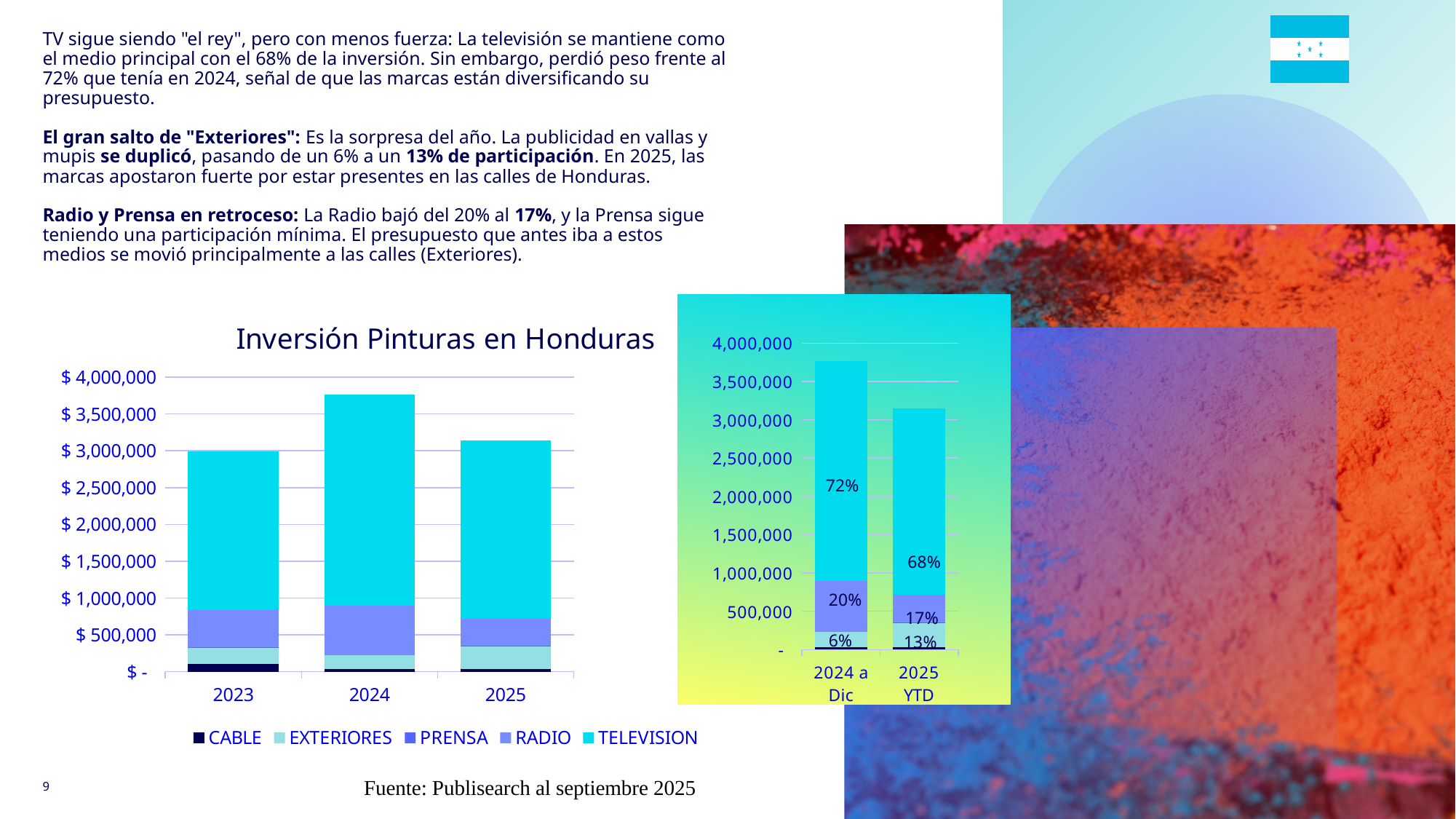
How many years are shown on the x axis of the 'Inversión Pinturas en Honduras' chart? 3 In the 'Inversión Pinturas en Honduras' chart, which total is larger, 2024 or 2025? 2024 In the 'Inversión Pinturas en Honduras' chart, is the total for 2023 greater or less than $ 3,500,000? less In the right-hand chart, what percentage label is printed on the top (cyan) segment of the '2025 YTD' bar? 68% In the right-hand chart, what percentage label is printed on the lowest labelled segment of the '2025 YTD' bar? 13% In the 'Inversión Pinturas en Honduras' chart, which year has the highest total investment? 2024 What kind of chart is 'Inversión Pinturas en Honduras' on the left of the slide? Stacked bar chart How many series does the legend of the 'Inversión Pinturas en Honduras' chart list? 5 In the right-hand chart, what percentage label is printed on the top (cyan) segment of the '2024 a Dic' bar? 72% In the right-hand chart, what is the difference between the top-segment labels of the '2024 a Dic' bar (72%) and the '2025 YTD' bar (68%)? 4 percentage points In the 'Inversión Pinturas en Honduras' chart, is the total for 2024 greater or less than $ 3,500,000? greater Which series is listed first in the legend of the 'Inversión Pinturas en Honduras' chart? CABLE